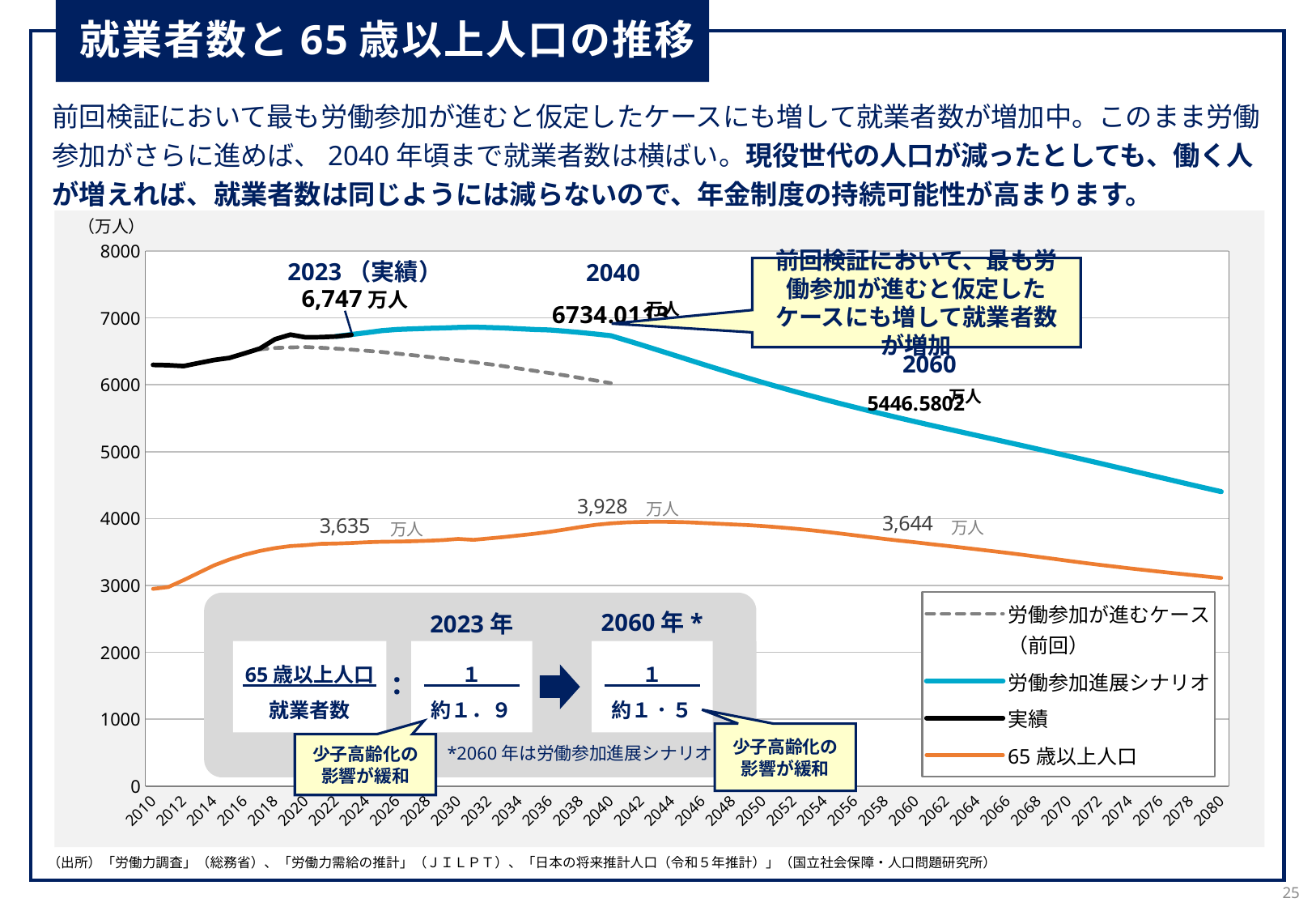
What is the labelled value of 65歳以上人口 in 2060? 3,644万人 In 2040, which is larger: the 労働参加進展シナリオ value or the 65歳以上人口 value? 労働参加進展シナリオ Is the value of the 65歳以上人口 line in 2080 greater or less than 4000? less What kind of chart is shown on the slide? line chart What is the 2023 (実績) value for the number of employed persons? 6,747万人 What is the difference between the 65歳以上人口 values labelled for 2040 and 2060? 284万人 Which of the three labelled 65歳以上人口 values (3,635, 3,928, 3,644) is the highest? 3,928万人 What is the value of the 労働参加進展シナリオ line in 2060? 5446.5802万人 What is the value of the 労働参加進展シナリオ line in 2040? 6734.01万人 What is the labelled value of 65歳以上人口 in 2040? 3,928万人 Does the 労働参加進展シナリオ line rise or fall between 2040 and 2080? fall How many series does the legend list? 4